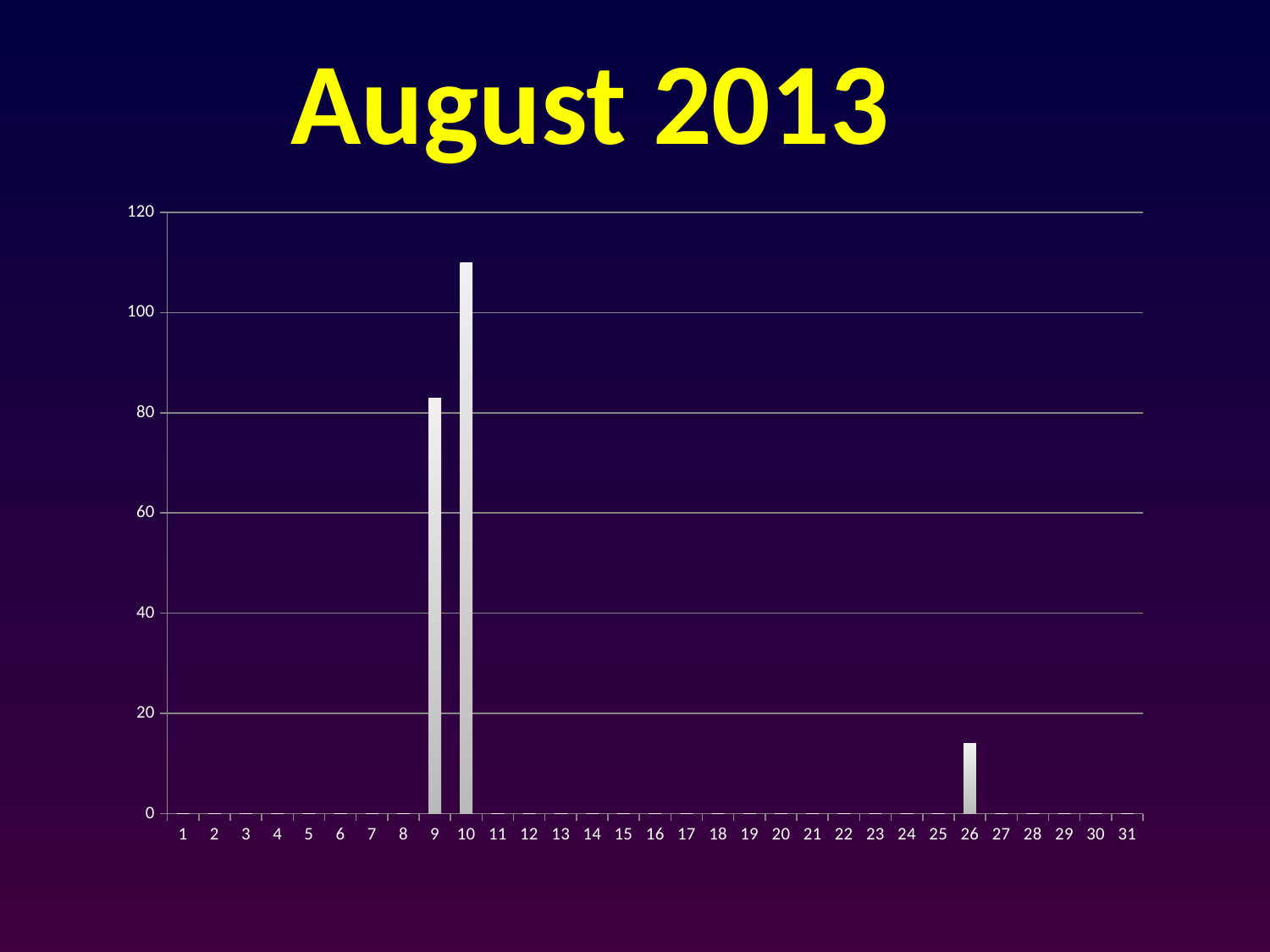
Which is larger, the value for day 9 or the value for day 10? 10 What is the highest value shown on the y axis? 120 How many categories are shown on the x axis? 31 Of the three days with visible bars, which has the shortest bar? 26 Which is larger, the value for day 26 or the value for day 9? 9 Is the value for day 9 greater or less than 100? less What is the title of the chart? August 2013 Is the value for day 26 greater or less than 20? less Which day has the highest bar? 10 Is the value for day 10 greater or less than 100? greater What type of chart is shown on the slide? bar chart